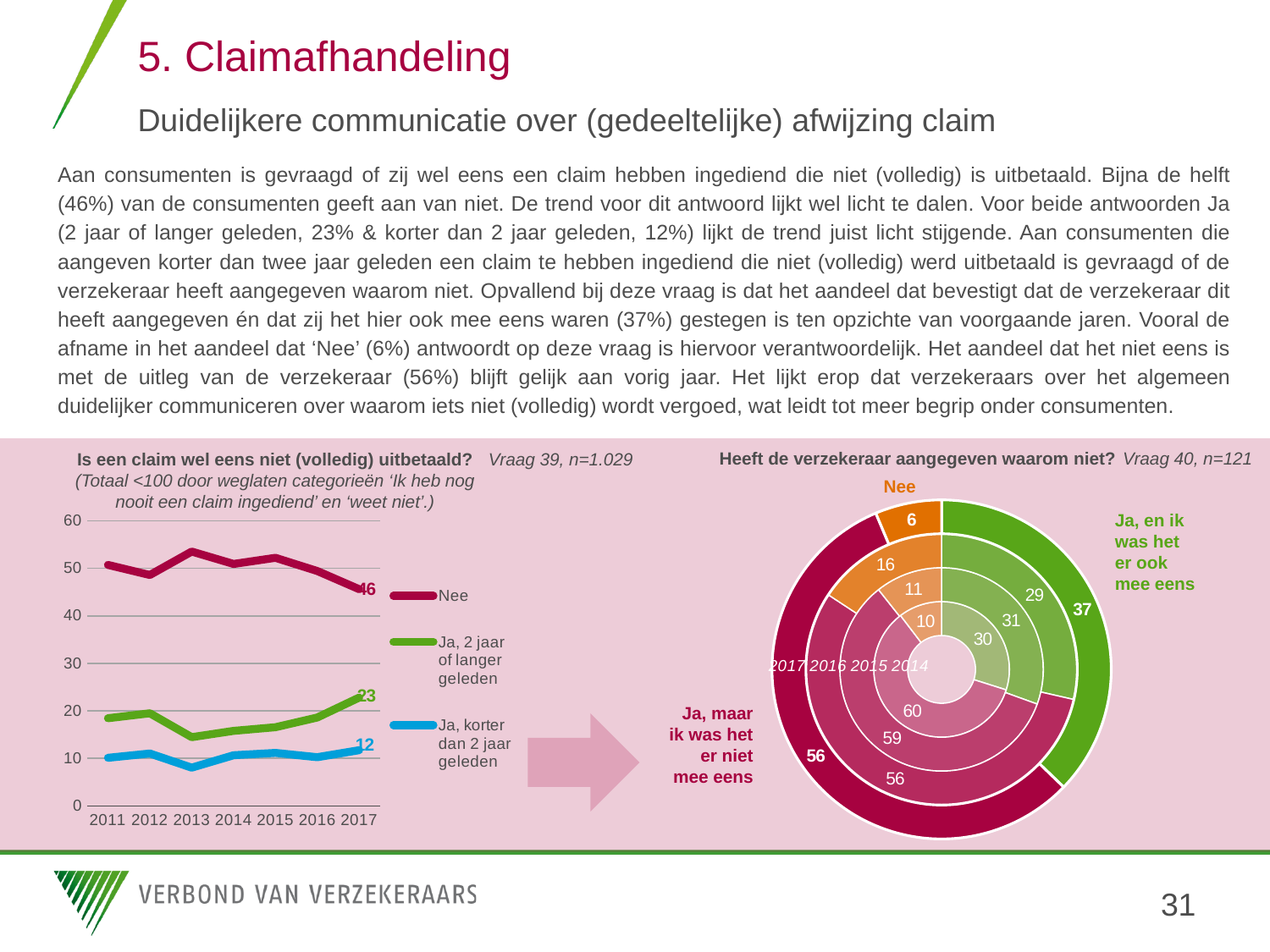
On the left chart 'Is een claim wel eens niet (volledig) uitbetaald?', what is the difference between 'Nee' and 'Ja, 2 jaar of langer geleden' in 2017? 23 On the right chart 'Heeft de verzekeraar aangegeven waarom niet?', which answer category has the highest value in 2017? Ja, maar ik was het er niet mee eens On the left chart 'Is een claim wel eens niet (volledig) uitbetaald?', how many years are shown on the x axis? 7 On the left chart 'Is een claim wel eens niet (volledig) uitbetaald?', what is the value for 'Ja, 2 jaar of langer geleden' in 2017? 23 On the left chart 'Is een claim wel eens niet (volledig) uitbetaald?', how many series does the legend list? 3 On the left chart 'Is een claim wel eens niet (volledig) uitbetaald?', what is the value for 'Ja, korter dan 2 jaar geleden' in 2017? 12 On the left chart 'Is een claim wel eens niet (volledig) uitbetaald?', is the value for 'Nee' in 2013 greater or less than 50? greater What kind of chart is the left chart 'Is een claim wel eens niet (volledig) uitbetaald?'? line chart On the left chart 'Is een claim wel eens niet (volledig) uitbetaald?', what is the value for 'Nee' in 2017? 46 On the left chart 'Is een claim wel eens niet (volledig) uitbetaald?', does the 'Nee' line rise or fall between 2015 and 2017? fall On the right chart 'Heeft de verzekeraar aangegeven waarom niet?', what is the value for 'Nee' in 2016? 16 On the right chart 'Heeft de verzekeraar aangegeven waarom niet?', what is the value for 'Ja, en ik was het er ook mee eens' in 2017? 37